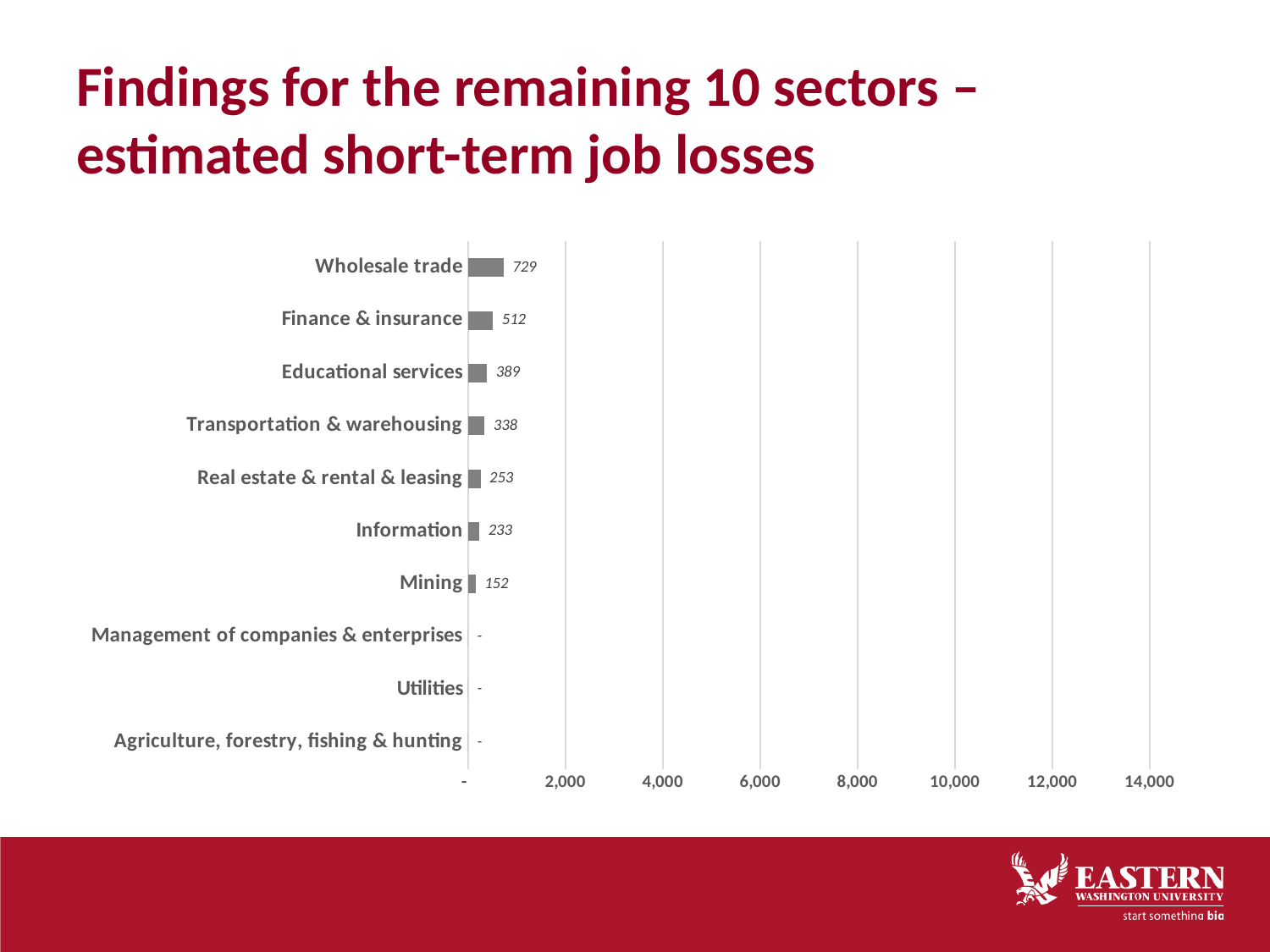
Is the value for Wholesale trade greater or less than 2,000? less What is the estimated short-term job loss for Wholesale trade? 729 What kind of chart is shown on the slide? Bar chart How many sectors show a dash (no value) instead of a bar? 3 What is the value shown for Finance & insurance? 512 What is the difference between the values for Wholesale trade and Finance & insurance? 217 Which is larger, the value for Real estate & rental & leasing or the value for Information? Real estate & rental & leasing How many sectors are listed on the chart? 10 Which sector has the highest estimated short-term job losses? Wholesale trade What is the value shown for Mining? 152 What is the difference between the values for Educational services and Information? 156 What is the value shown for Transportation & warehousing? 338